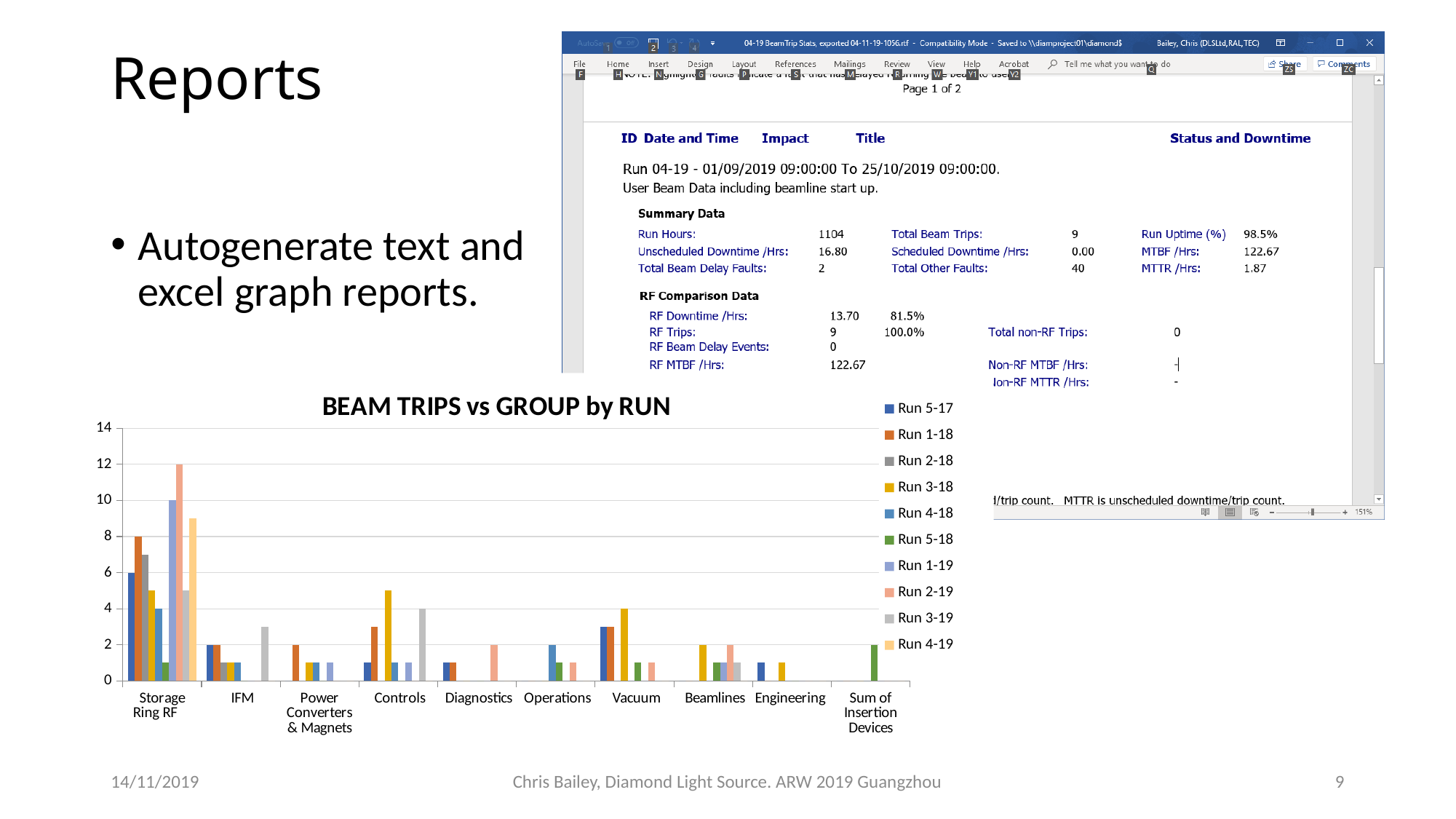
What is the title of the chart on the slide? BEAM TRIPS vs GROUP by RUN Is the value for Run 1-18 in the Storage Ring RF group greater or less than 6? greater Which run has the highest number of beam trips for Storage Ring RF? Run 2-19 How many series does the legend of the chart list? 10 What is the value for Run 1-19 in the Storage Ring RF group? 10 What is the first series listed in the chart legend? Run 5-17 Which is larger in the Storage Ring RF group: the value for Run 2-19 or the value for Run 1-19? Run 2-19 How many group categories are shown along the x axis of the chart? 10 Which group has the tallest bar in the chart? Storage Ring RF What kind of chart is shown on the slide? bar chart Is the value for Run 3-18 in the Controls group greater or less than 4? greater What is the value for Run 2-19 in the Storage Ring RF group? 12